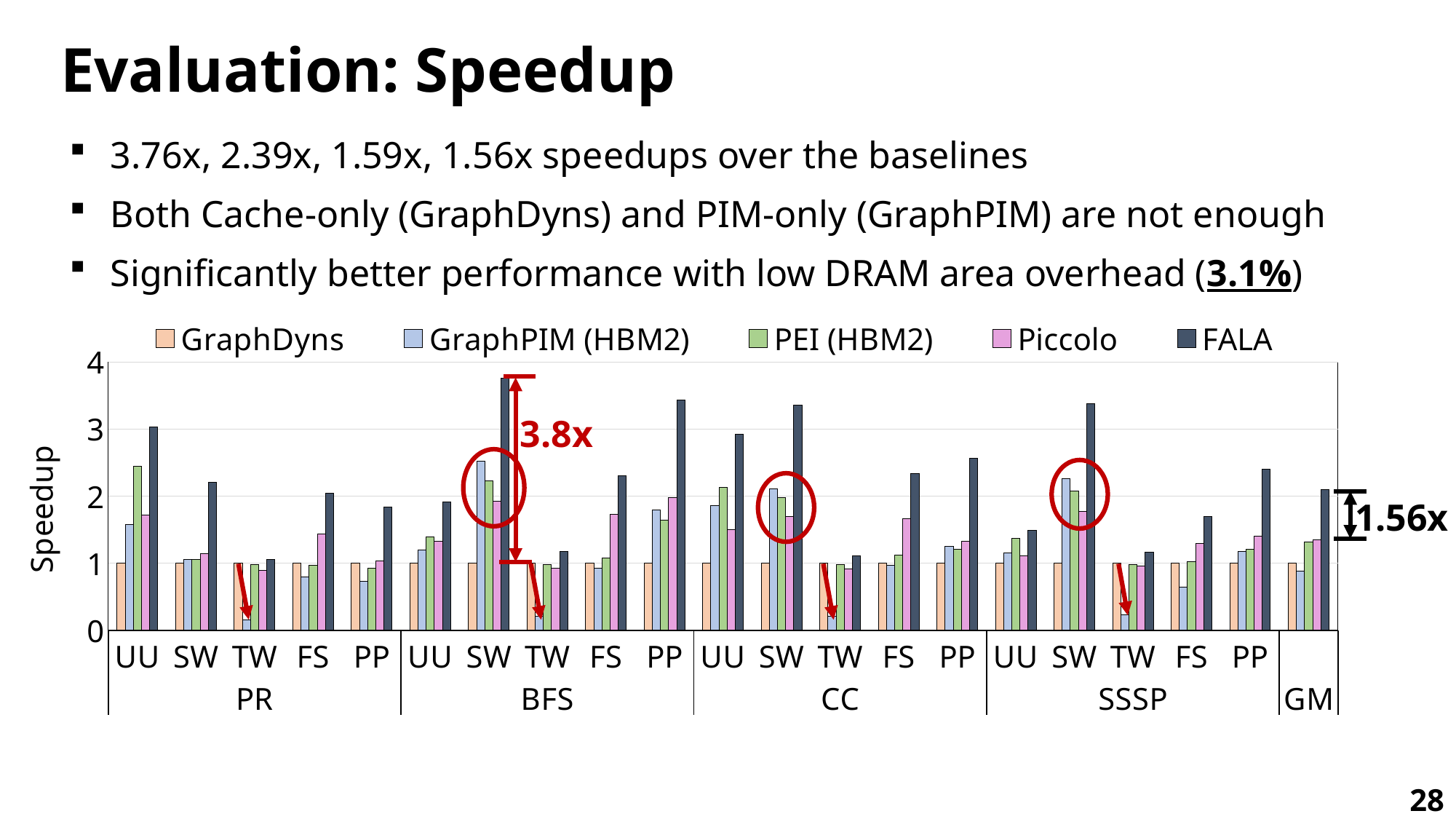
For the UU input under PR, which is larger: the PEI (HBM2) bar or the GraphPIM (HBM2) bar? PEI (HBM2) What speedup figure is annotated next to the GM group on the right of the chart? 1.56x Which series has the highest bar in the GM group? FALA How many series does the chart legend list? 5 Which series has the highest bar for the SW input under BFS? FALA What is the label of the y-axis of the chart? Speedup Is the FALA value for the FS input under SSSP greater or less than 2? less Is the FALA value for the SW input under BFS greater or less than 3? greater Which series has the lowest bar for the TW input under PR? GraphPIM (HBM2) How many input graphs (UU, SW, TW, FS, PP) are shown for each algorithm group such as PR? 5 Is the GraphPIM (HBM2) value for the TW input under PR greater or less than 1? less What kind of chart is shown on the slide? bar chart